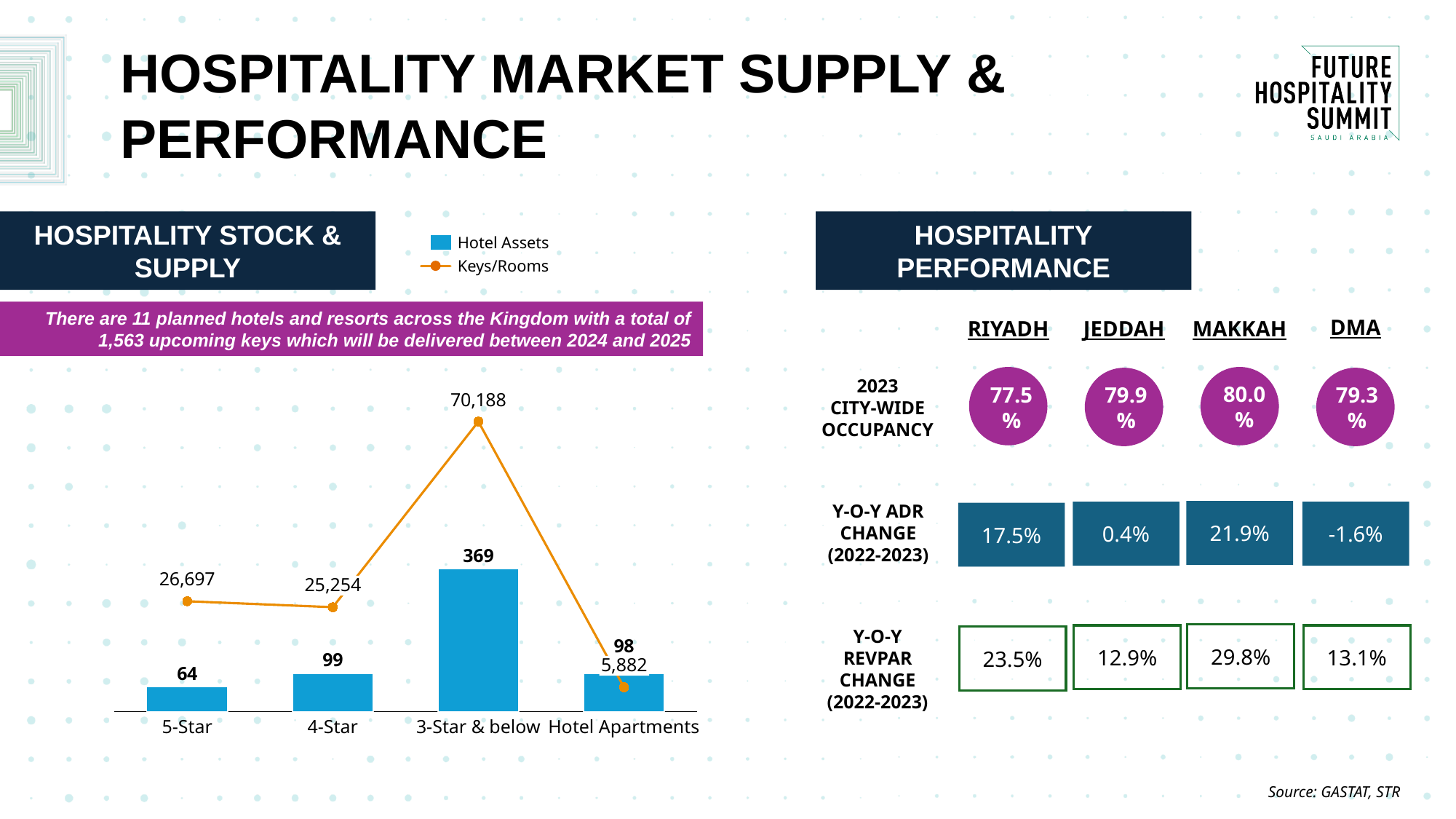
In the Hospitality Stock & Supply chart, which has more Keys/Rooms, 5-Star or 4-Star? 5-Star In the Hospitality Stock & Supply chart, which category has the lowest number of Keys/Rooms? Hotel Apartments How many categories are shown on the x axis of the Hospitality Stock & Supply chart? 4 In the Hospitality Stock & Supply chart, how many Keys/Rooms are there for Hotel Apartments? 5,882 How many series does the legend of the Hospitality Stock & Supply chart list? 2 In the Hospitality Stock & Supply chart, which category has the highest number of Hotel Assets? 3-Star & below In the Hospitality Stock & Supply chart, how many Keys/Rooms are there for 5-Star? 26,697 In the Hospitality Stock & Supply chart, how many Hotel Assets are there for 3-Star & below? 369 In the Hospitality Stock & Supply chart, what is the difference in Keys/Rooms between 3-Star & below and 4-Star? 44,934 In the Hospitality Stock & Supply chart, which category has the lowest number of Hotel Assets? 5-Star What kind of chart is the Hospitality Stock & Supply chart? Combined bar and line chart In the Hospitality Stock & Supply chart, what is the difference in Hotel Assets between 4-Star and 5-Star? 35